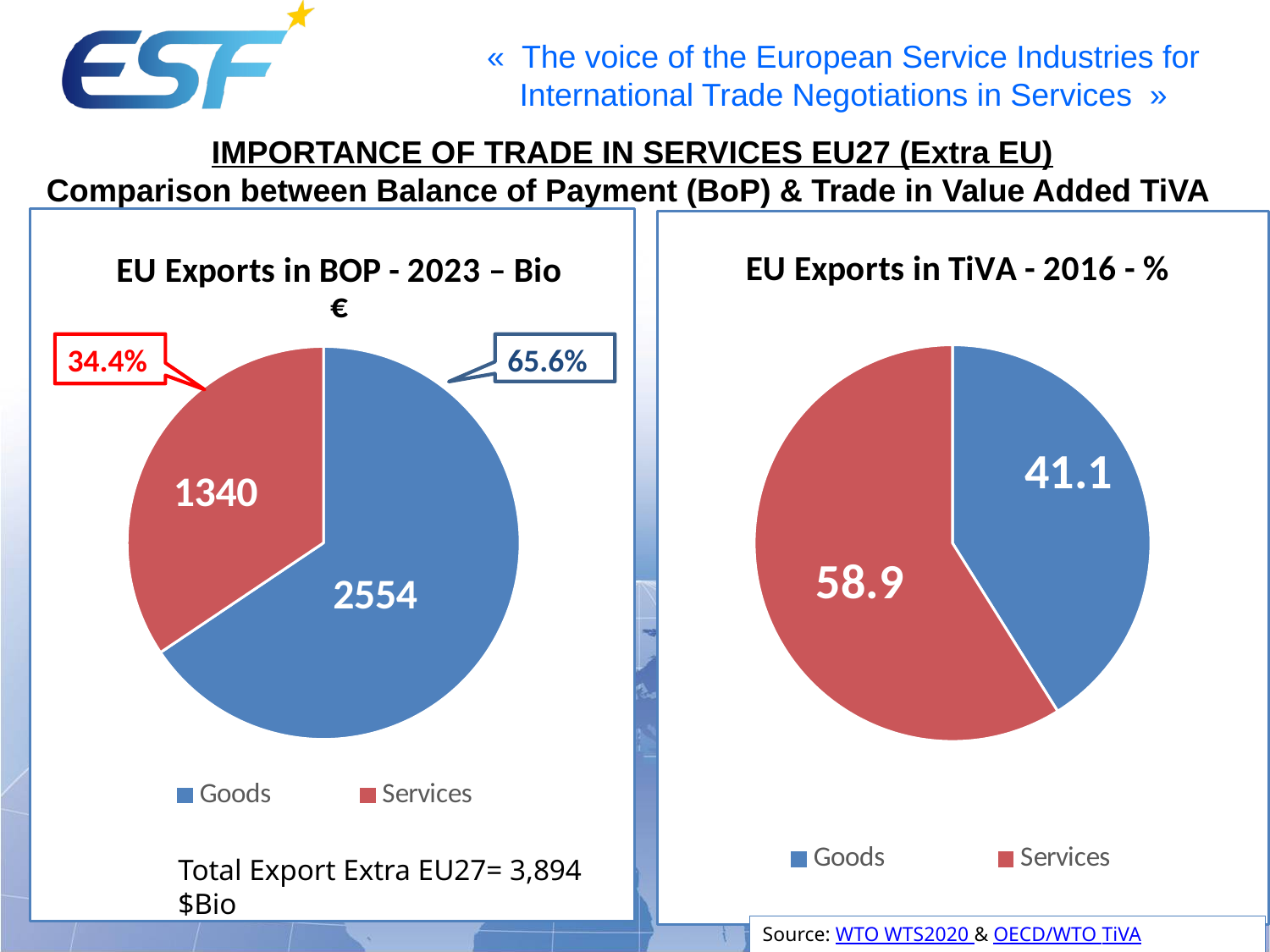
In the 'EU Exports in BOP - 2023' chart, what is the value for Goods? 2554 In the 'EU Exports in TiVA - 2016' chart, what is the value for Goods? 41.1 In the 'EU Exports in BOP - 2023' chart, which category has the larger slice? Goods In the 'EU Exports in BOP - 2023' chart, what percentage share is shown for Goods? 65.6% What type of chart is used on the left side of the slide? Pie chart How many categories does the legend of the 'EU Exports in TiVA - 2016' chart list? 2 In the 'EU Exports in BOP - 2023' chart, what is the difference between the Goods and Services values? 1214 In the 'EU Exports in TiVA - 2016' chart, what is the value for Services? 58.9 In the 'EU Exports in BOP - 2023' chart, what percentage share is shown for Services? 34.4% In the 'EU Exports in BOP - 2023' chart, what is the value for Services? 1340 In the 'EU Exports in TiVA - 2016' chart, is the value for Services larger or smaller than the value for Goods? larger In the 'EU Exports in TiVA - 2016' chart, which category has the smaller slice? Goods